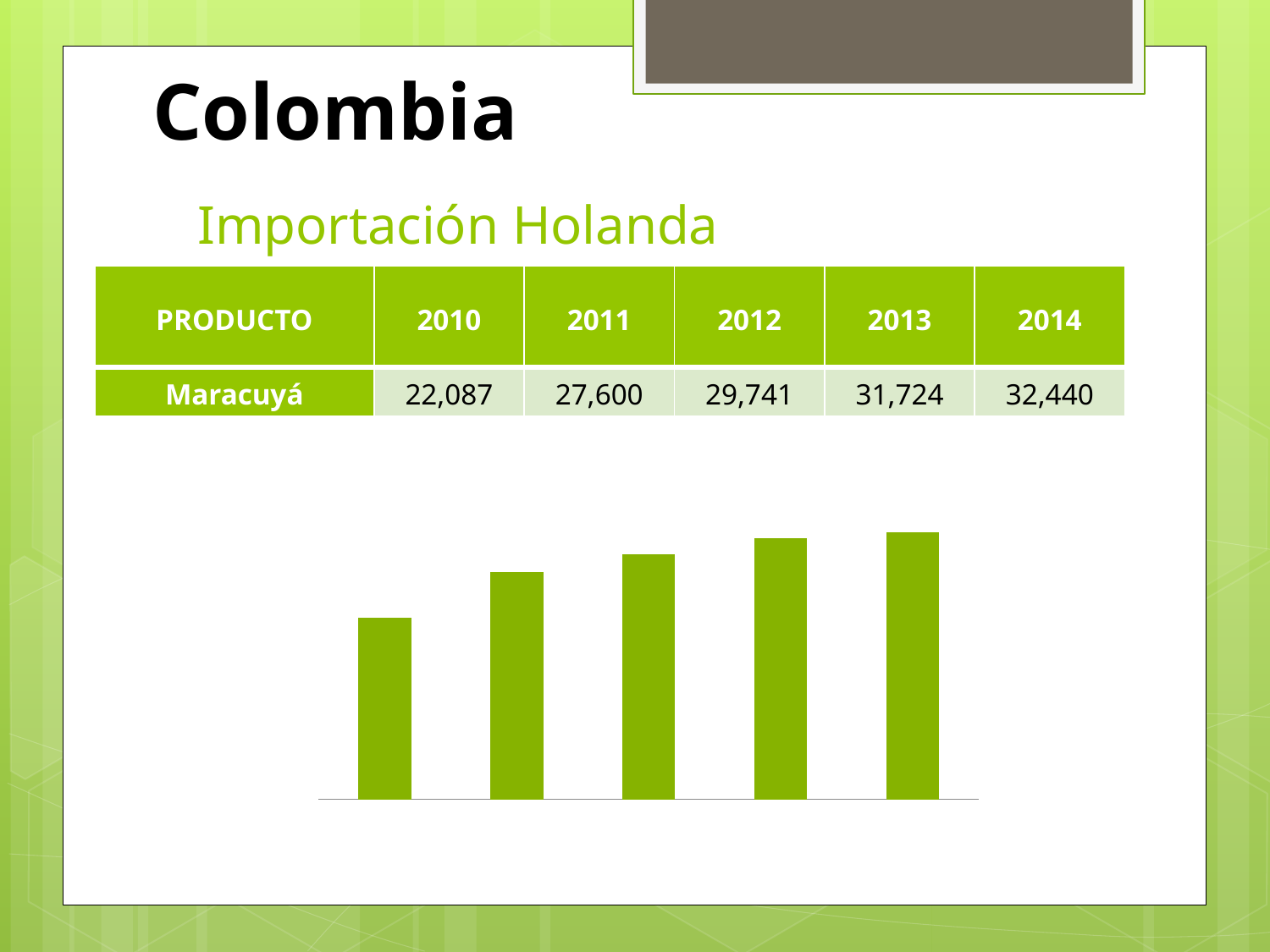
According to the table above the chart, what is the Maracuyá import value for 2010? 22,087 Using the table values, what is the difference between the 2014 and 2010 Maracuyá import values? 10,353 What kind of chart is shown on the slide? bar chart How many bars does the chart show? 5 Do the bar heights rise or fall from left to right across the chart? rise According to the table above the chart, what is the Maracuyá import value for 2012? 29,741 What is the subtitle shown above the table and chart? Importación Holanda Which product is listed in the table above the chart? Maracuyá Which bar is the shortest in the chart: the leftmost or the rightmost? leftmost According to the table above the chart, what is the Maracuyá import value for 2014? 32,440 Which bar is the tallest in the chart: the leftmost or the rightmost? rightmost Using the table values, which year has the larger Maracuyá import value, 2011 or 2013? 2013